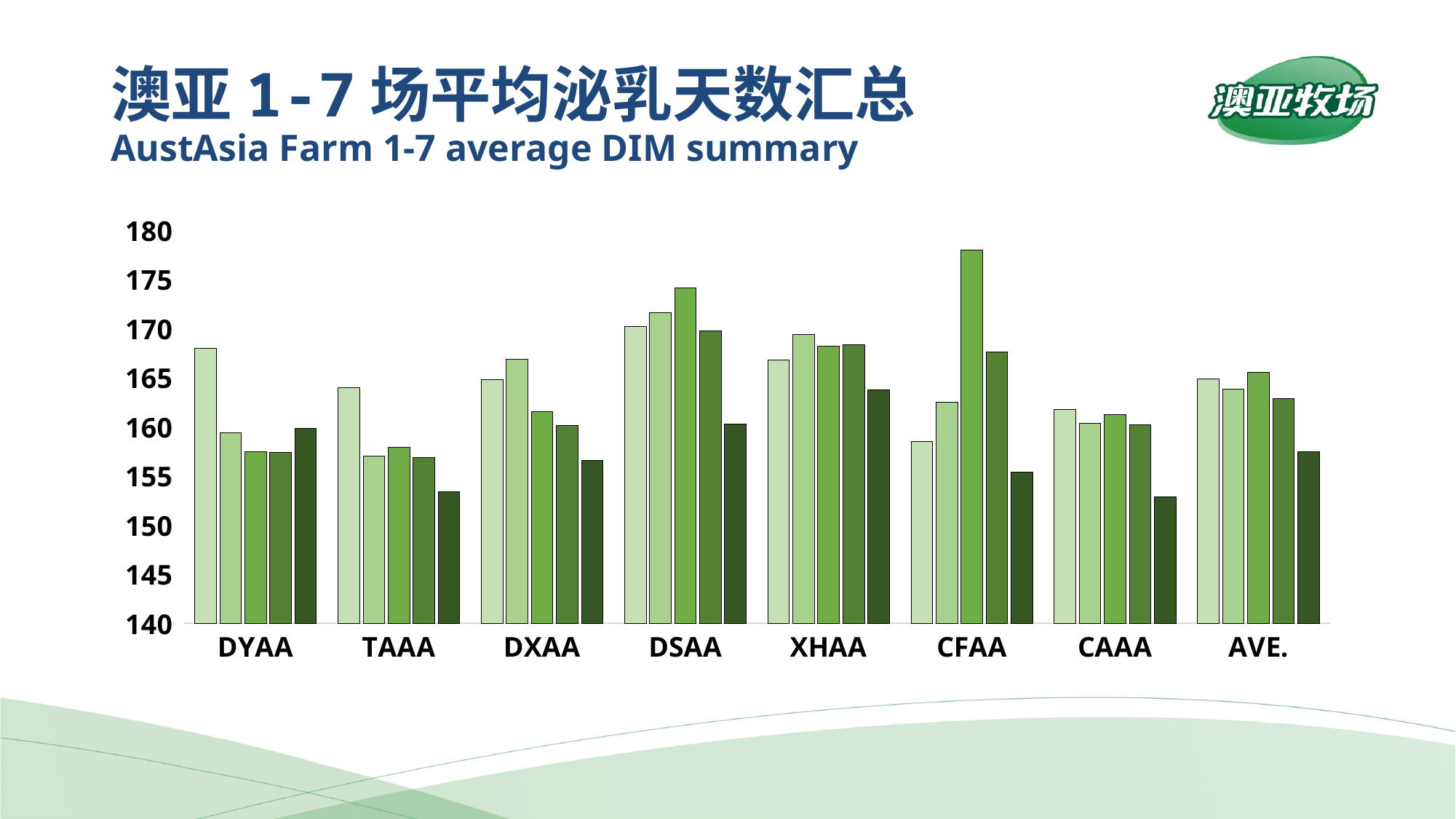
What is the highest value shown on the y axis of the chart? 180 Is the value of the third bar for CFAA greater or less than 175? greater Is the value of the third bar for DSAA greater or less than 170? greater Which category contains the tallest bar in the chart? CFAA How many bars are plotted for each category in the chart? 5 What kind of chart is shown on the slide? bar chart Is the value of the last (darkest) bar for CAAA greater or less than 155? less Which is larger: the first (lightest) bar for DSAA or the first (lightest) bar for DYAA? DSAA What is the English subtitle of the chart slide? AustAsia Farm 1-7 average DIM summary How many categories are shown along the x axis of the chart? 8